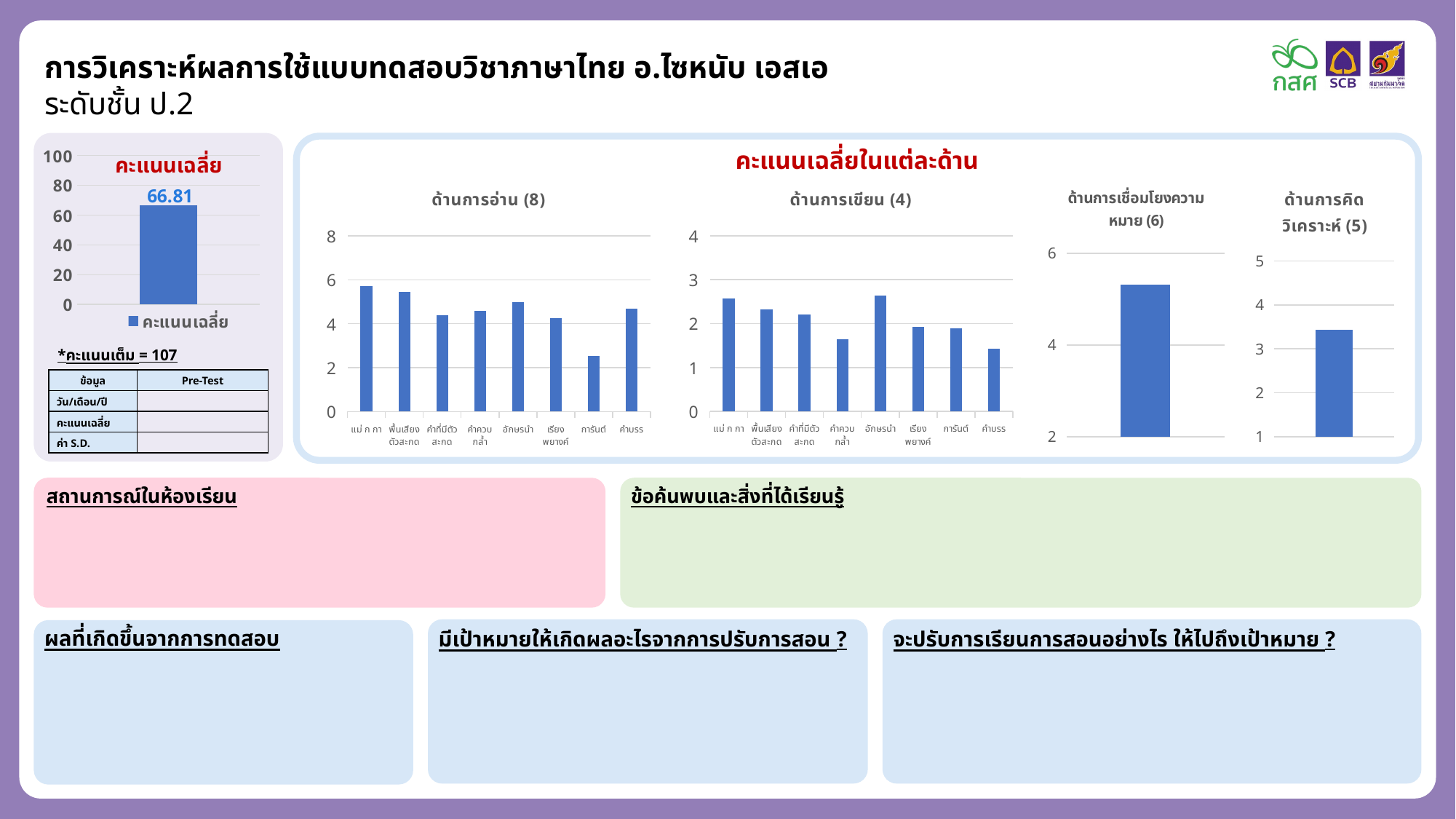
How many categories are plotted in the "ด้านการเขียน (4)" chart? 8 In the "คะแนนเฉลี่ย" chart on the left, what is the value shown on the bar? 66.81 In the "ด้านการอ่าน (8)" chart, is the value for แม่ ก กา greater or less than 4? greater In the "ด้านการเชื่อมโยงความหมาย (6)" chart, is the value of the bar greater or less than 4? greater How many categories are plotted in the "ด้านการอ่าน (8)" chart? 8 What kind of chart is the "คะแนนเฉลี่ย" chart on the left? bar chart In the "ด้านการอ่าน (8)" chart, which category has the lowest value? การันต์ In the "ด้านการเขียน (4)" chart, is the value for คำบรร greater or less than 2? less How many series does the legend of the "คะแนนเฉลี่ย" chart list? 1 In the "ด้านการอ่าน (8)" chart, which is larger, the value for แม่ ก กา or the value for การันต์? แม่ ก กา